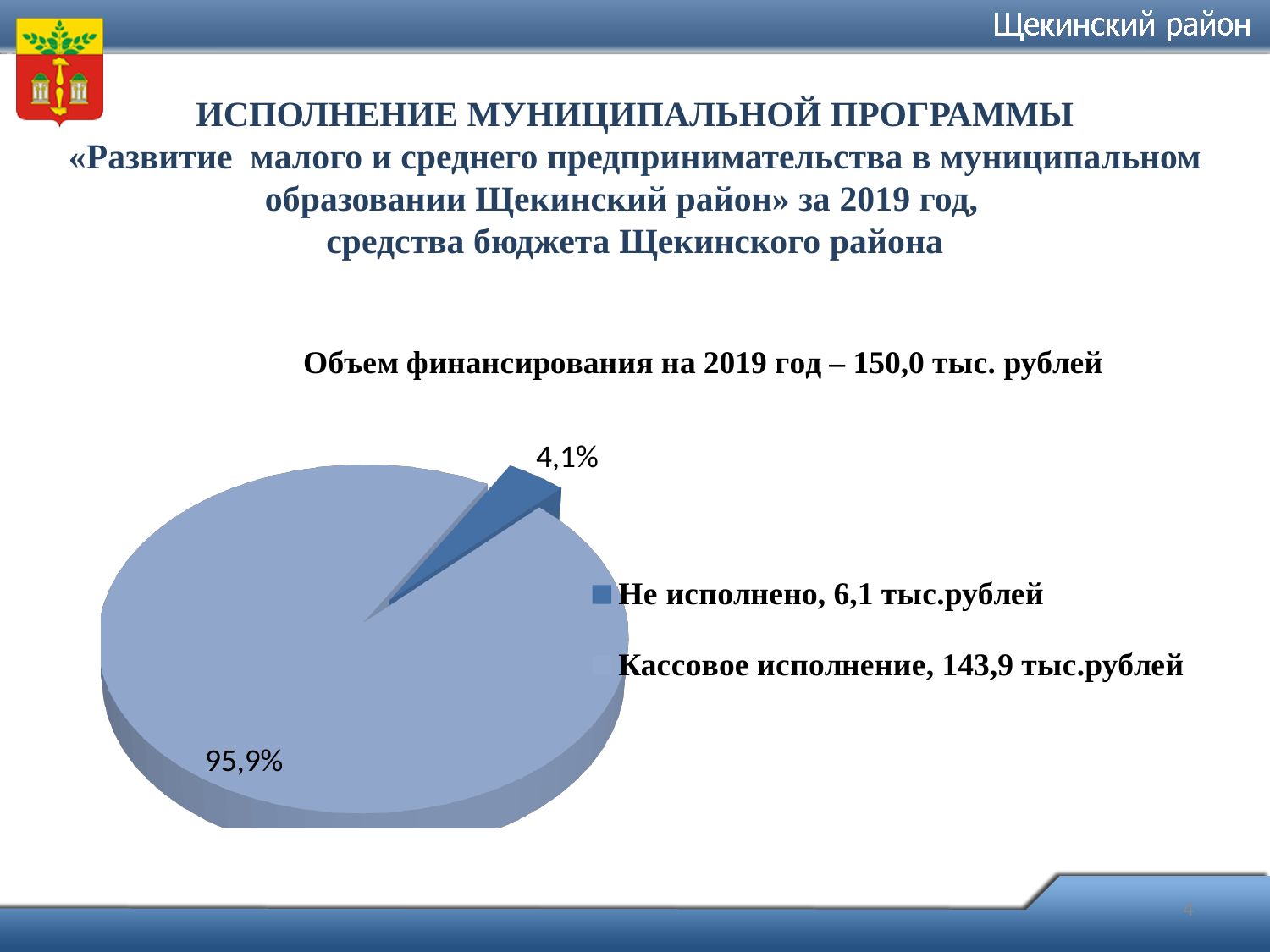
Which slice of the pie chart is the smallest? Не исполнено What value in тыс.рублей is given in the legend for "Кассовое исполнение"? 143,9 тыс.рублей What share of the pie does the slice "Не исполнено" represent? 4,1% How many entries does the legend of the pie chart list? 2 How many slices does the pie chart have? 2 Which slice of the pie chart is the largest? Кассовое исполнение What share of the pie does the slice "Кассовое исполнение" represent? 95,9% What is the difference in percentage points between the shares of "Кассовое исполнение" and "Не исполнено"? 91,8 What kind of chart is shown on the slide? pie chart What value in тыс.рублей is given in the legend for "Не исполнено"? 6,1 тыс.рублей Which is larger: the share for "Кассовое исполнение" or the share for "Не исполнено"? Кассовое исполнение What total funding amount for 2019 is stated in the chart title? 150,0 тыс. рублей